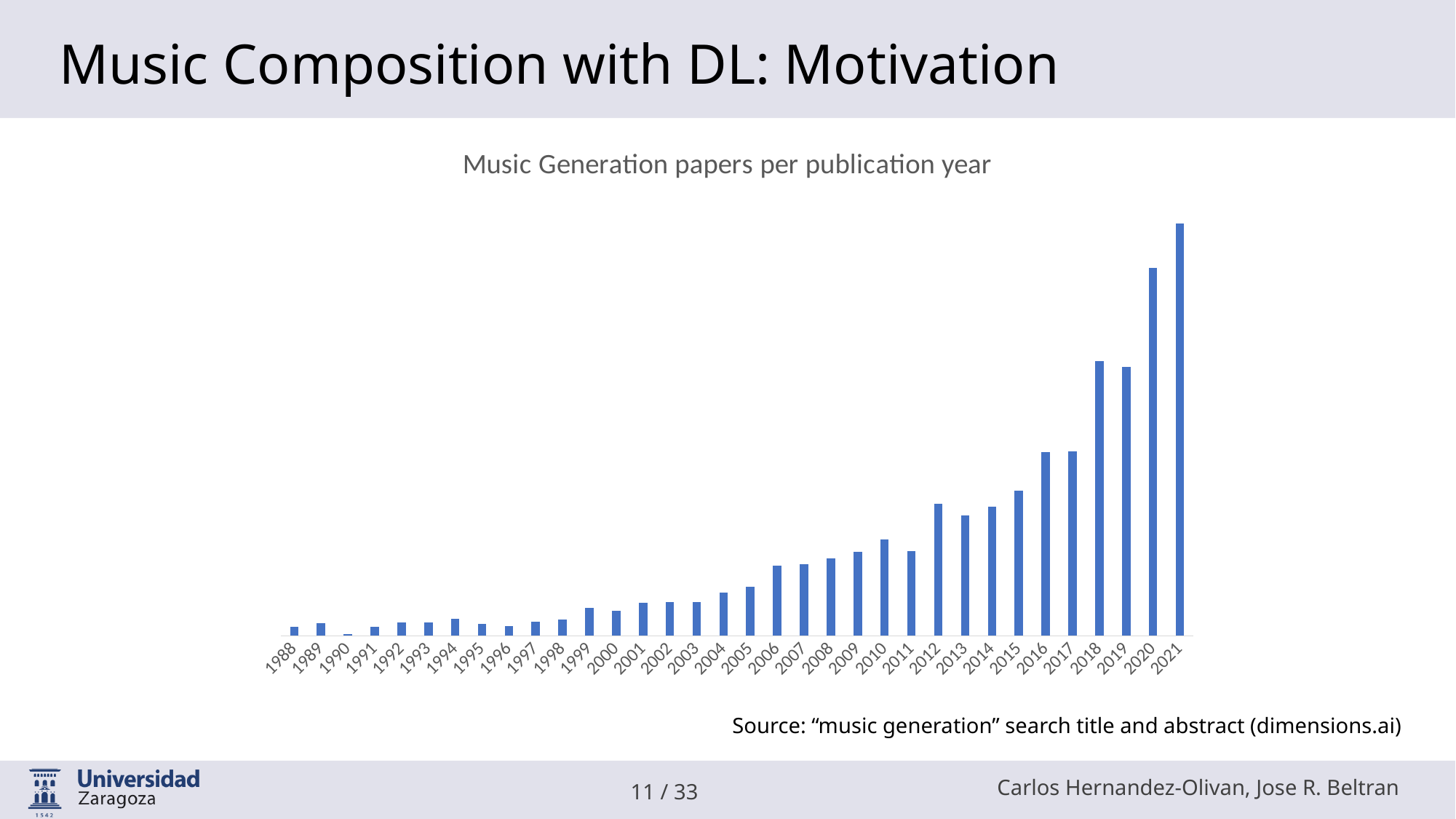
Which year has more papers, 2005 or 2006? 2006 Which year has more papers, 2019 or 2020? 2020 Which year has more papers, 1999 or 2000? 1999 What is the first year shown on the x axis? 1988 Overall, do the number of papers rise or fall from 1988 to 2021? rise What is the title of the chart? Music Generation papers per publication year Which year has the highest number of music generation papers? 2021 How many years (bars) are shown in the chart? 34 Which year has the lowest number of music generation papers? 1990 What kind of chart is shown on the slide? bar chart